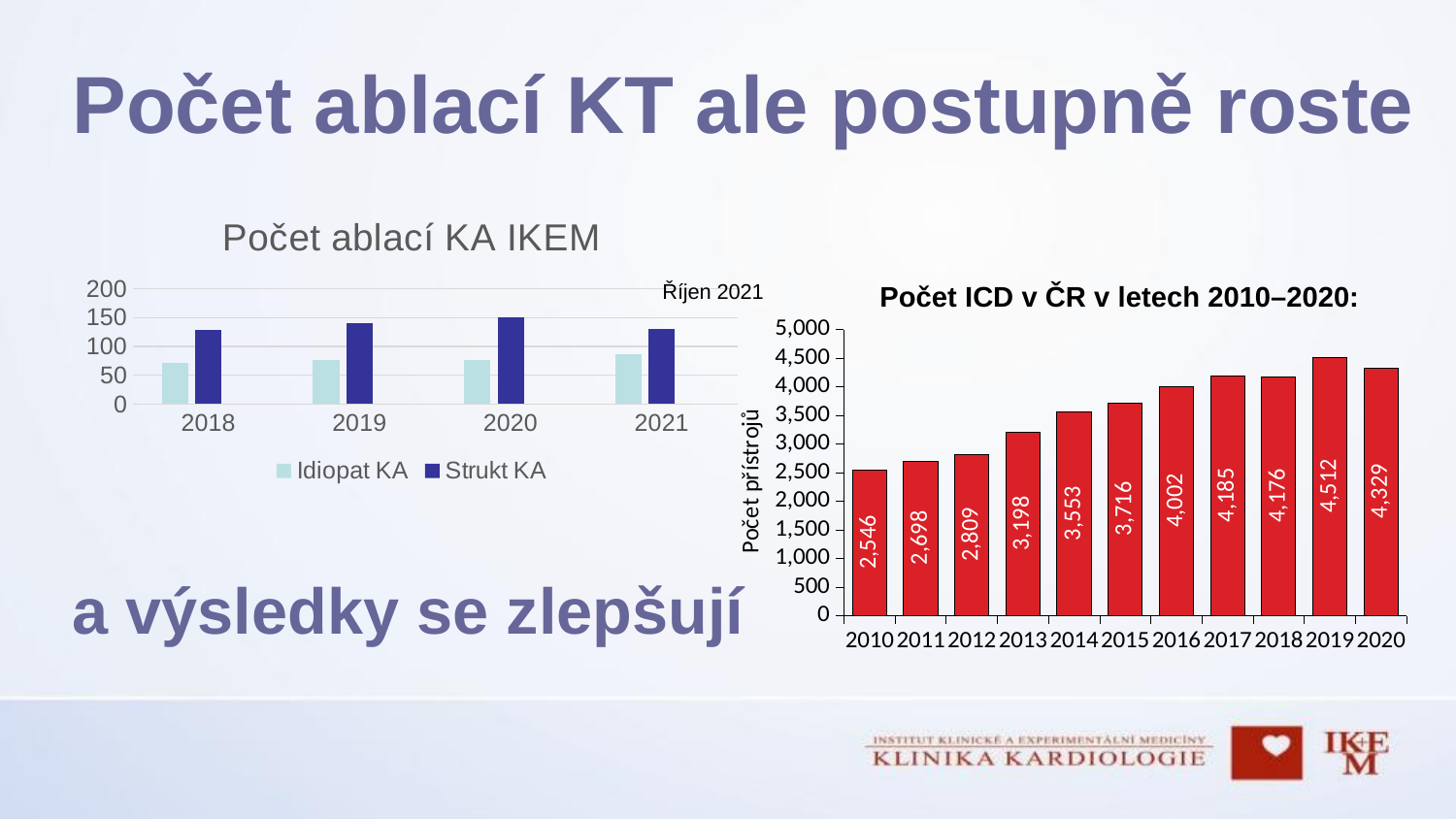
In the chart titled "Počet ICD v ČR v letech 2010–2020:", which year has the lowest value? 2010 What kind of chart is the chart titled "Počet ablací KA IKEM"? bar chart In the chart titled "Počet ICD v ČR v letech 2010–2020:", what is the label of the vertical axis? Počet přístrojů In the chart titled "Počet ICD v ČR v letech 2010–2020:", what is the value for 2015? 3,716 In the chart titled "Počet ablací KA IKEM", how many series does the legend list? 2 In the chart titled "Počet ICD v ČR v letech 2010–2020:", how many years are shown on the x axis? 11 In the chart titled "Počet ICD v ČR v letech 2010–2020:", what is the value for 2010? 2,546 In the chart titled "Počet ICD v ČR v letech 2010–2020:", which is larger, the value for 2017 or the value for 2018? 2017 In the chart titled "Počet ablací KA IKEM", is the value for Strukt KA in 2020 greater or less than 100? greater In the chart titled "Počet ablací KA IKEM", which is larger in 2019, Idiopat KA or Strukt KA? Strukt KA In the chart titled "Počet ICD v ČR v letech 2010–2020:", which year has the highest value? 2019 In the chart titled "Počet ICD v ČR v letech 2010–2020:", what is the difference between the values for 2019 and 2020? 183